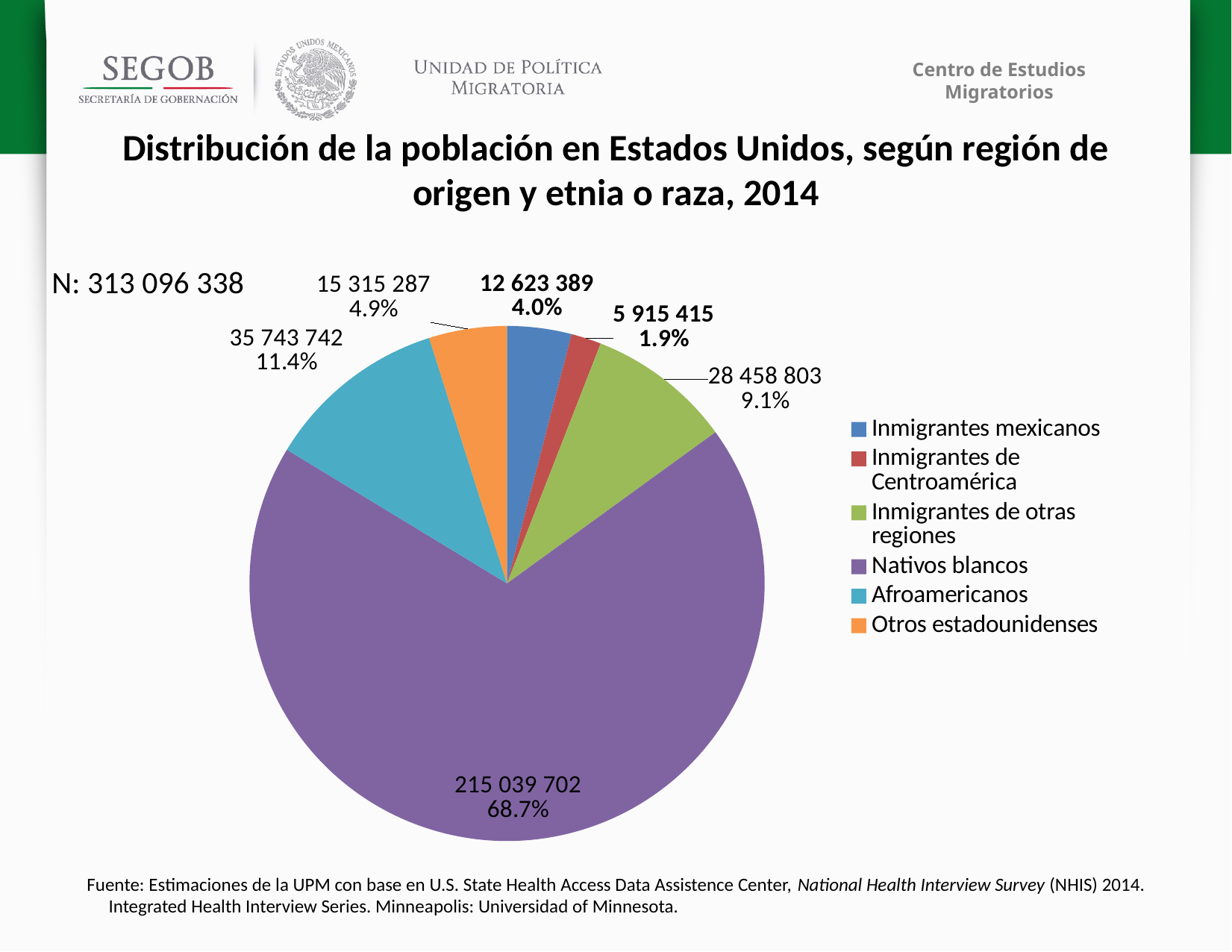
What colour is the slice for Otros estadounidenses? orange What is the population value shown for Nativos blancos? 215 039 702 What percentage share of the pie does Afroamericanos represent? 11.4% What percentage share does Inmigrantes de Centroamérica have in the pie? 1.9% What is the value shown for Inmigrantes mexicanos? 12 623 389 What total population (N) is stated on the slide? 313 096 338 What is the difference between the value for Afroamericanos and the value for Inmigrantes de otras regiones? 7 284 939 What kind of chart is shown on the slide? pie chart Which is larger, the value for Inmigrantes de otras regiones or the value for Otros estadounidenses? Inmigrantes de otras regiones How many slices does the pie chart have? 6 Which category has the largest slice of the pie? Nativos blancos Which category has the smallest slice of the pie? Inmigrantes de Centroamérica